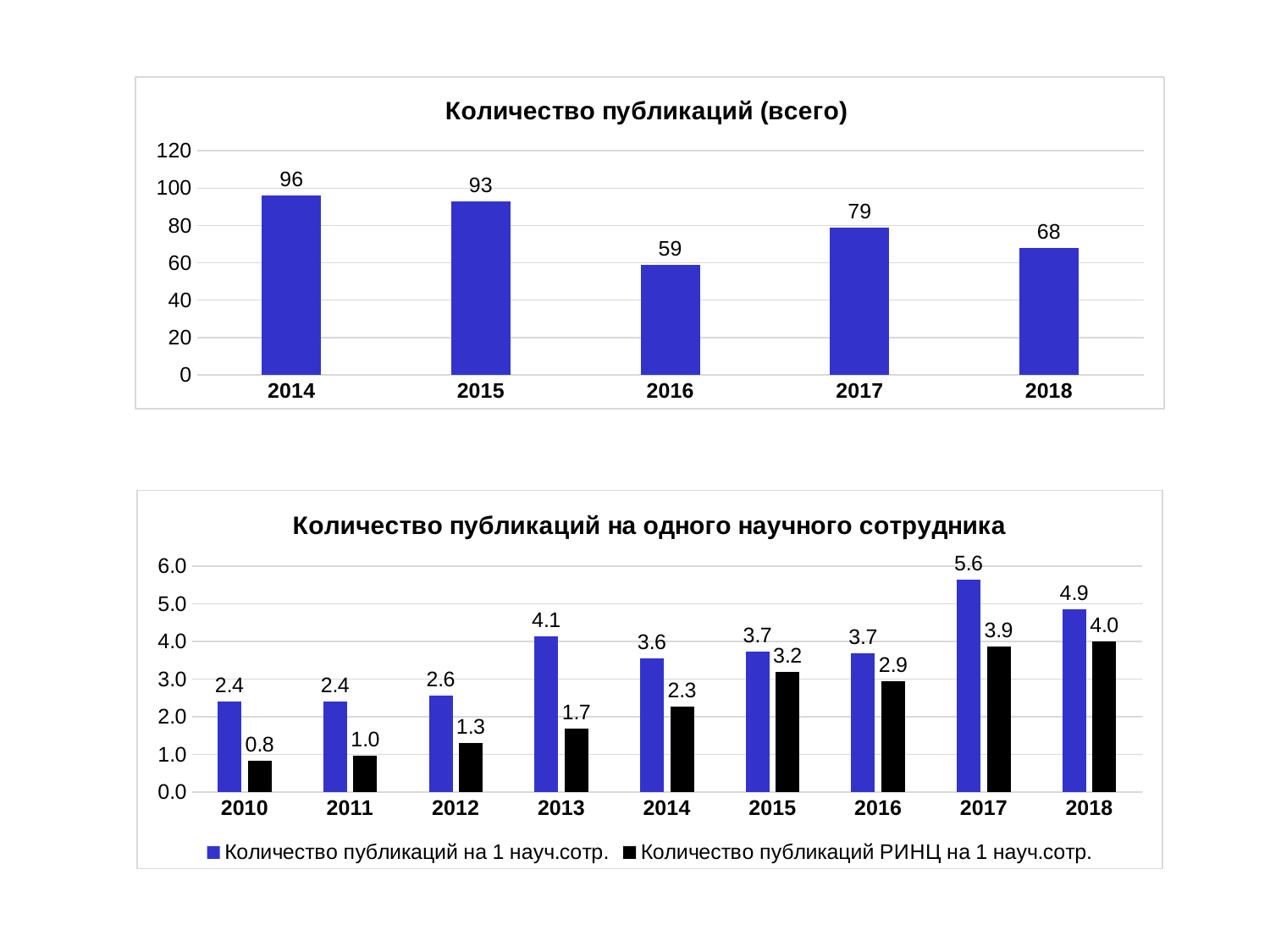
In the chart titled "Количество публикаций (всего)", which year has the highest value? 2014 In the chart titled "Количество публикаций на одного научного сотрудника", what is the value of "Количество публикаций РИНЦ на 1 науч.сотр." for 2015? 3.2 In the chart titled "Количество публикаций на одного научного сотрудника", how many series does the legend list? 2 In the chart titled "Количество публикаций на одного научного сотрудника", what is the difference between the two series' values for 2018? 0.9 In the chart titled "Количество публикаций на одного научного сотрудника", which year has the highest value for "Количество публикаций на 1 науч.сотр."? 2017 In the chart titled "Количество публикаций на одного научного сотрудника", which year has the lowest value for "Количество публикаций РИНЦ на 1 науч.сотр."? 2010 In the chart titled "Количество публикаций (всего)", how many years are shown on the x axis? 5 In the chart titled "Количество публикаций (всего)", which year has the lowest value? 2016 What kind of chart is the chart titled "Количество публикаций (всего)"? bar chart In the chart titled "Количество публикаций (всего)", what is the difference between the values for 2014 and 2018? 28 In the chart titled "Количество публикаций на одного научного сотрудника", what is the value of "Количество публикаций на 1 науч.сотр." for 2013? 4.1 In the chart titled "Количество публикаций (всего)", what is the value for 2016? 59